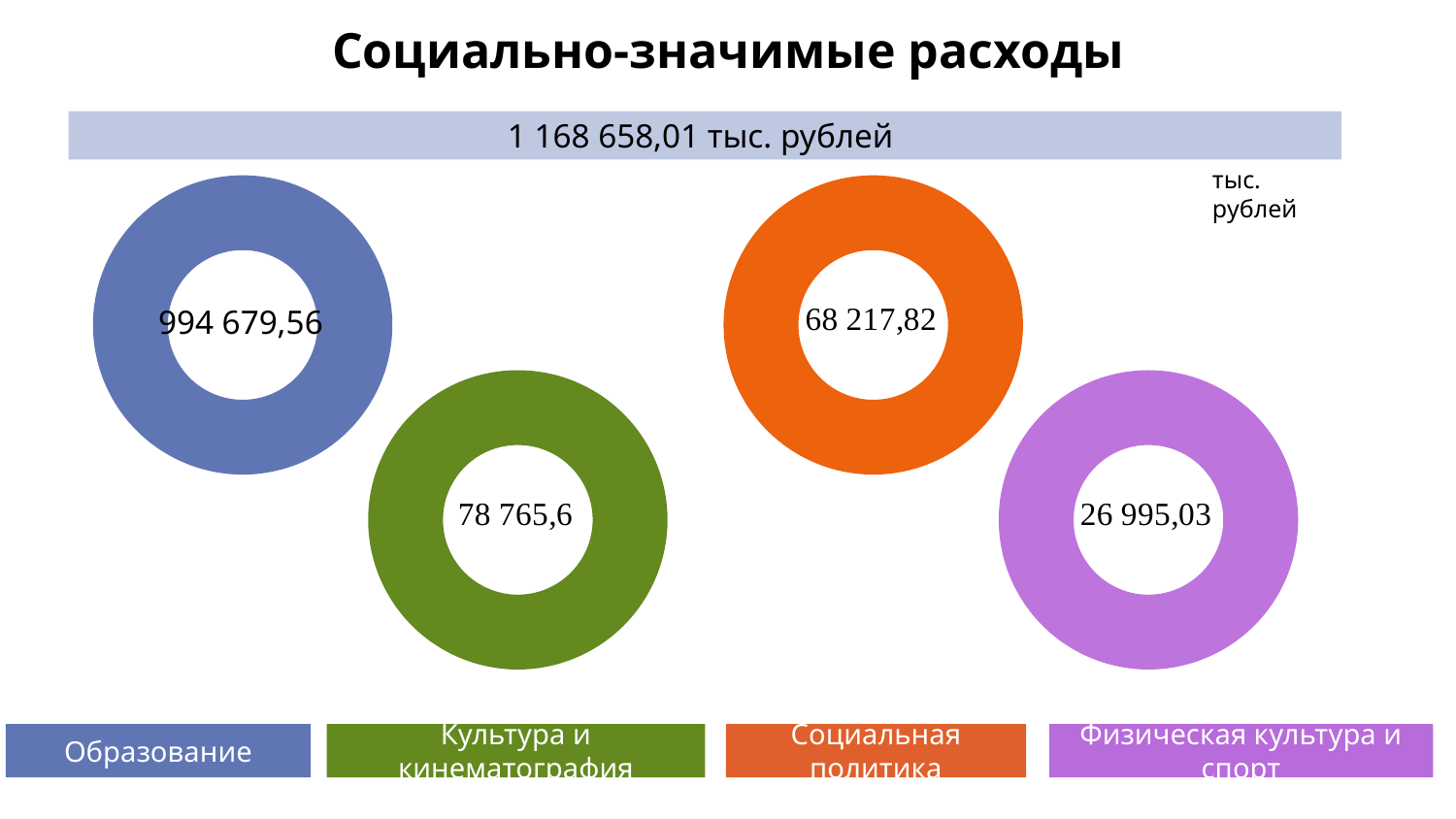
What is the difference between the values for Образование and Культура и кинематография? 915 913,96 What is the total of all socially significant expenditures shown on the slide? 1 168 658,01 тыс. рублей Which is larger, the value for Культура и кинематография or the value for Социальная политика? Культура и кинематография Which category has the highest value? Образование What is the value shown for Культура и кинематография? 78 765,6 What is the value shown for Физическая культура и спорт? 26 995,03 How many expenditure categories are shown on the slide? 4 Which category has the lowest value? Физическая культура и спорт What is the value shown for Образование? 994 679,56 What is the value shown for Социальная политика? 68 217,82 What colour is the ring for Социальная политика? Orange What is the difference between the values for Социальная политика and Физическая культура и спорт? 41 222,79